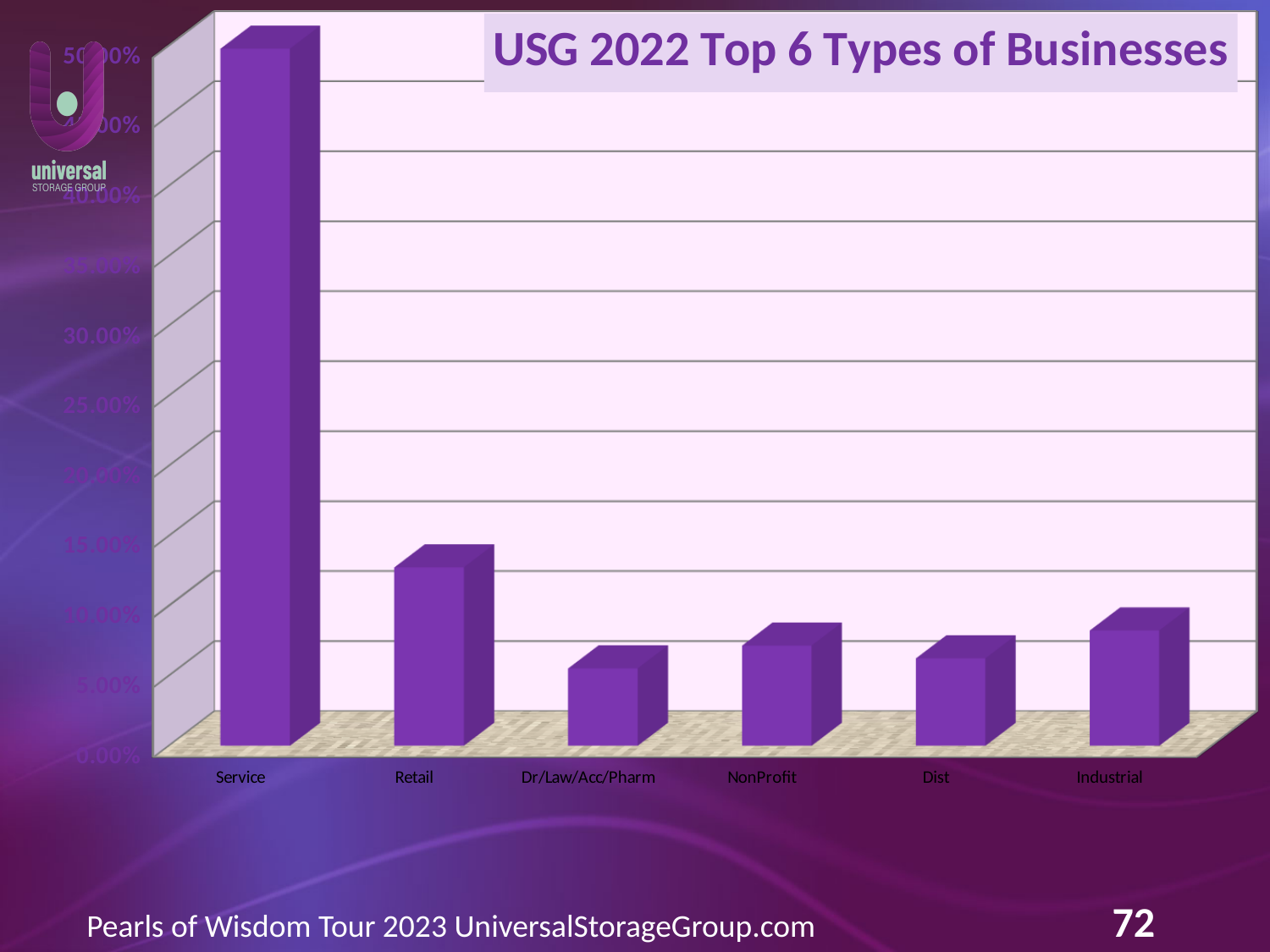
Is the value for Service greater or less than 40.00%? greater Is the value for Dr/Law/Acc/Pharm greater or less than 10.00%? less Is the value for Industrial greater or less than 10.00%? less How many business types are plotted on the chart? 6 Which business type has the highest value? Service Which is larger, the value for Service or the value for Retail? Service What kind of chart is shown on the slide? bar chart What is the title of the chart? USG 2022 Top 6 Types of Businesses What is the label of the first category on the x axis? Service Which is larger, the value for Retail or the value for NonProfit? Retail